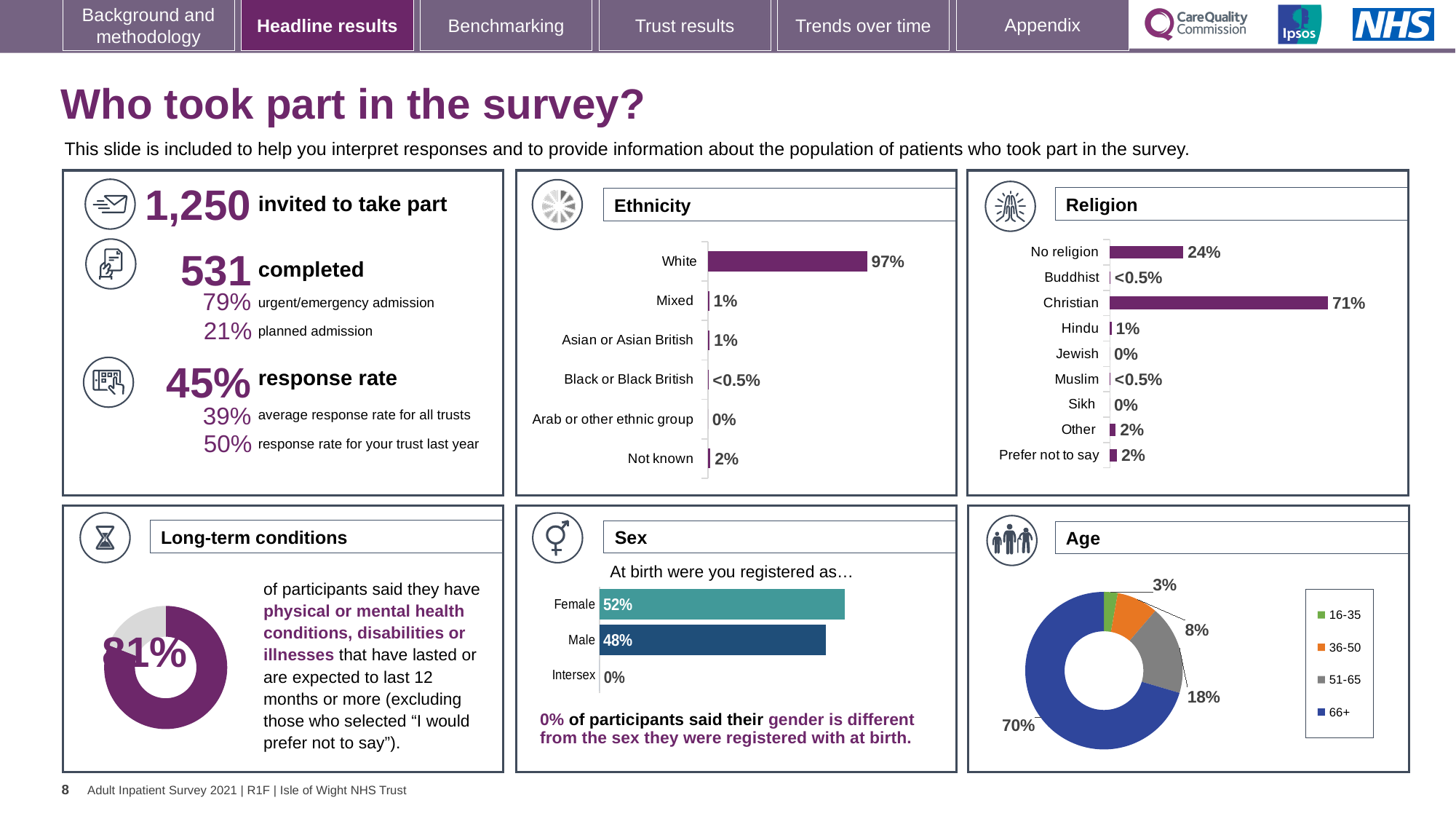
In the Religion chart, what is the difference between the Christian and No religion values? 47% In the Age chart, what share of participants were aged 66+? 70% In the Sex chart, what percentage of participants were registered as Male at birth? 48% How many categories are shown in the Ethnicity chart? 6 How many categories are shown in the Religion chart? 9 In the Ethnicity chart, what percentage of participants were White? 97% How many entries does the legend of the Age chart list? 4 In the Long-term conditions chart, what percentage of participants said they have a long-term condition? 81% What kind of chart is the Age chart? Donut (pie) chart In the Sex chart, which is larger, Female or Male? Female In the Ethnicity chart, which category has the highest value? White In the Religion chart, what percentage of participants were Christian? 71%